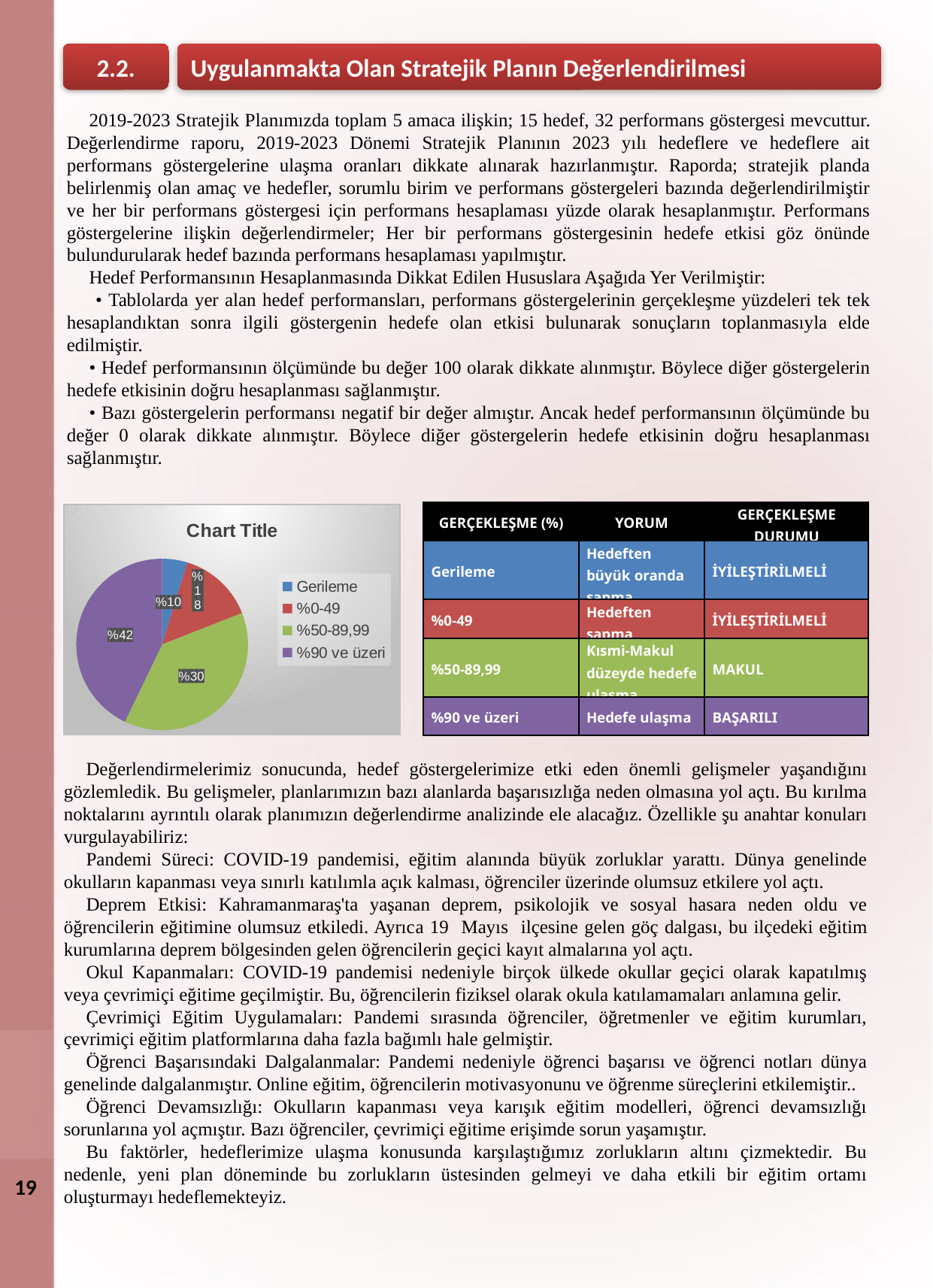
What value is shown for the '%50-89,99' slice? %30 What value is shown for the '%0-49' slice? %18 Which slice is larger, '%0-49' or '%50-89,99'? %50-89,99 What kind of chart is shown on the slide? pie chart What value is shown for the '%90 ve üzeri' slice? %42 Which category has the smallest slice of the pie? Gerileme What is the title of the chart? Chart Title What is the difference between the '%90 ve üzeri' slice and the 'Gerileme' slice? %32 What value is shown for the 'Gerileme' slice? %10 How many entries does the chart legend list? 4 Which category has the largest slice of the pie? %90 ve üzeri How many slices does the pie chart have? 4